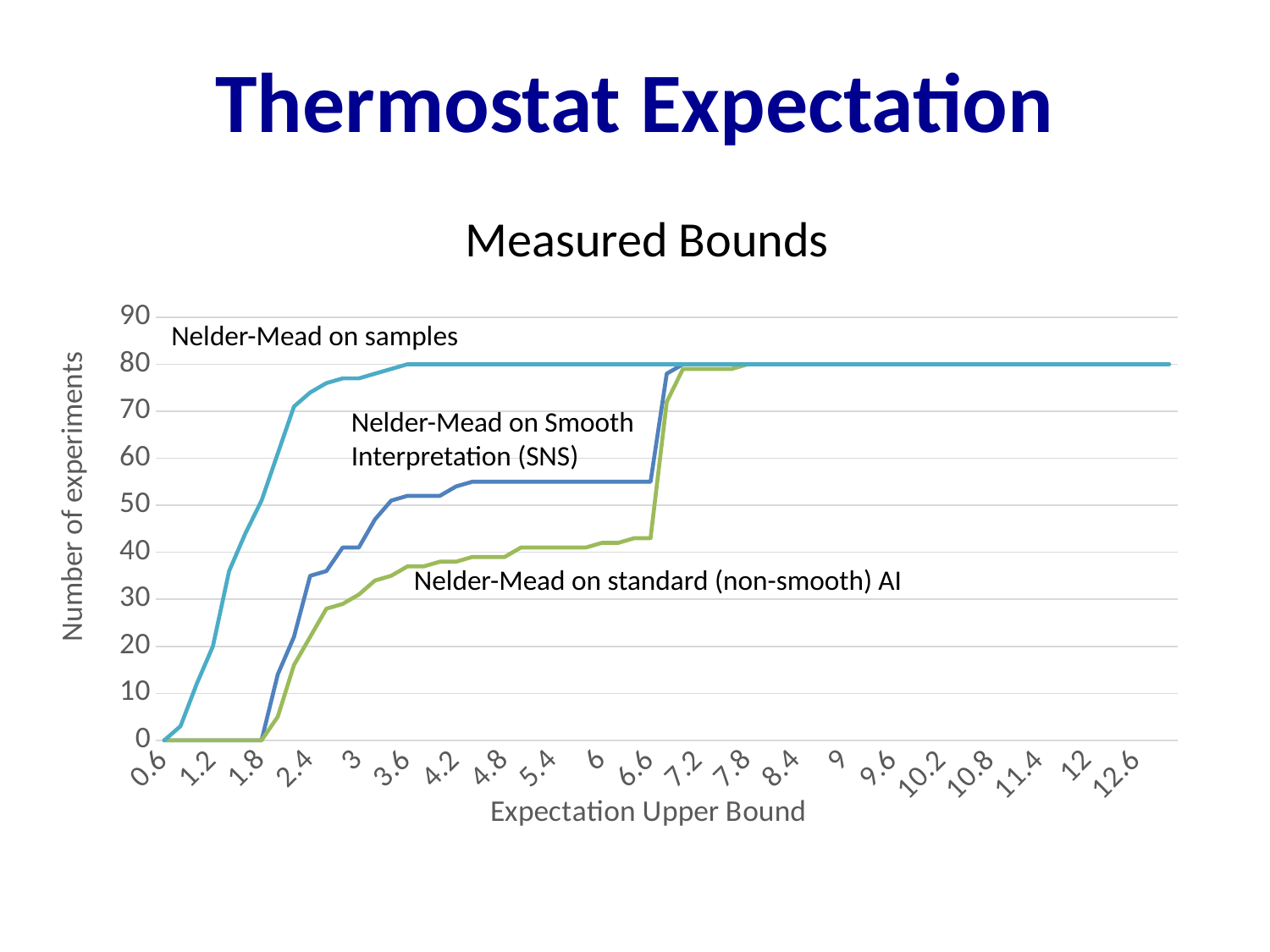
Is the value for Nelder-Mead on samples at an expectation upper bound of 2.4 greater or less than 60? greater Do the values of the lines rise or fall as the expectation upper bound increases? rise At an expectation upper bound of 4.2, which line is higher: Nelder-Mead on Smooth Interpretation (SNS) or Nelder-Mead on standard (non-smooth) AI? Nelder-Mead on Smooth Interpretation (SNS) Is the value for Nelder-Mead on Smooth Interpretation (SNS) at an expectation upper bound of 4.8 greater or less than 50? greater At an expectation upper bound of 3, which line is higher: Nelder-Mead on samples or Nelder-Mead on standard (non-smooth) AI? Nelder-Mead on samples What kind of chart is shown on the slide? line chart Is the value for Nelder-Mead on standard (non-smooth) AI at an expectation upper bound of 4.8 greater or less than 50? less What is the title of the chart? Measured Bounds At what value on the y axis do all three lines plateau? 80 How many lines (series) are plotted in the chart? 3 What is the label of the x axis? Expectation Upper Bound